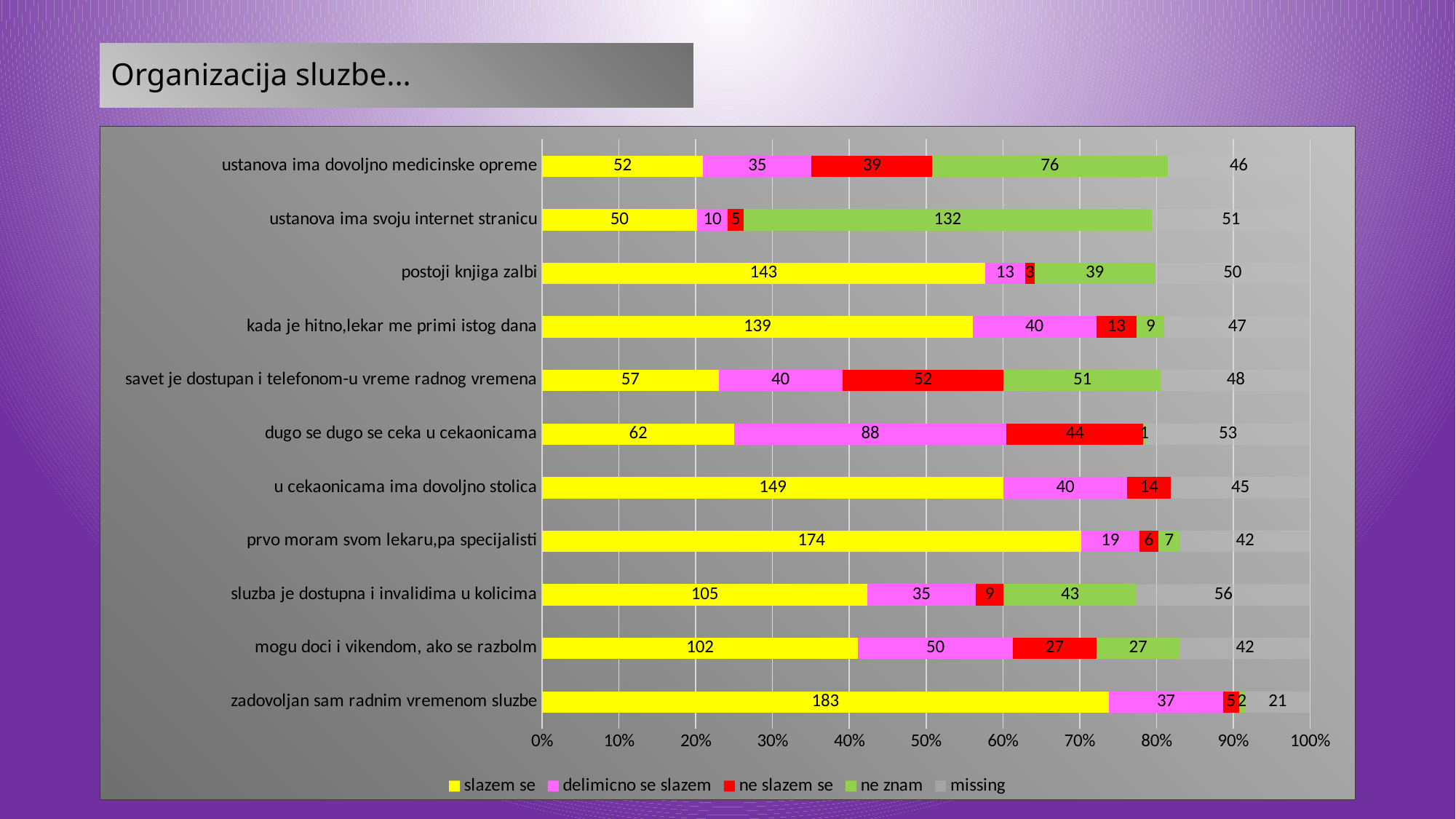
What is the total of all values in the bar for "ustanova ima dovoljno medicinske opreme"? 248 What is the value of "ne znam" for "ustanova ima svoju internet stranicu"? 132 How many series does the legend list? 5 Which category has the lowest "missing" value? zadovoljan sam radnim vremenom sluzbe Which has a larger "ne slazem se" value: "savet je dostupan i telefonom-u vreme radnog vremena" or "ustanova ima dovoljno medicinske opreme"? savet je dostupan i telefonom-u vreme radnog vremena What colour represents the "slazem se" series in the legend? yellow What is the "missing" value for "sluzba je dostupna i invalidima u kolicima"? 56 What kind of chart is shown on the slide? stacked bar chart Which category has the highest "slazem se" value? zadovoljan sam radnim vremenom sluzbe What is the value of "slazem se" for "postoji knjiga zalbi"? 143 For "dugo se dugo se ceka u cekaonicama", what is the difference between the "delimicno se slazem" value and the "slazem se" value? 26 How many categories are shown on the chart? 11